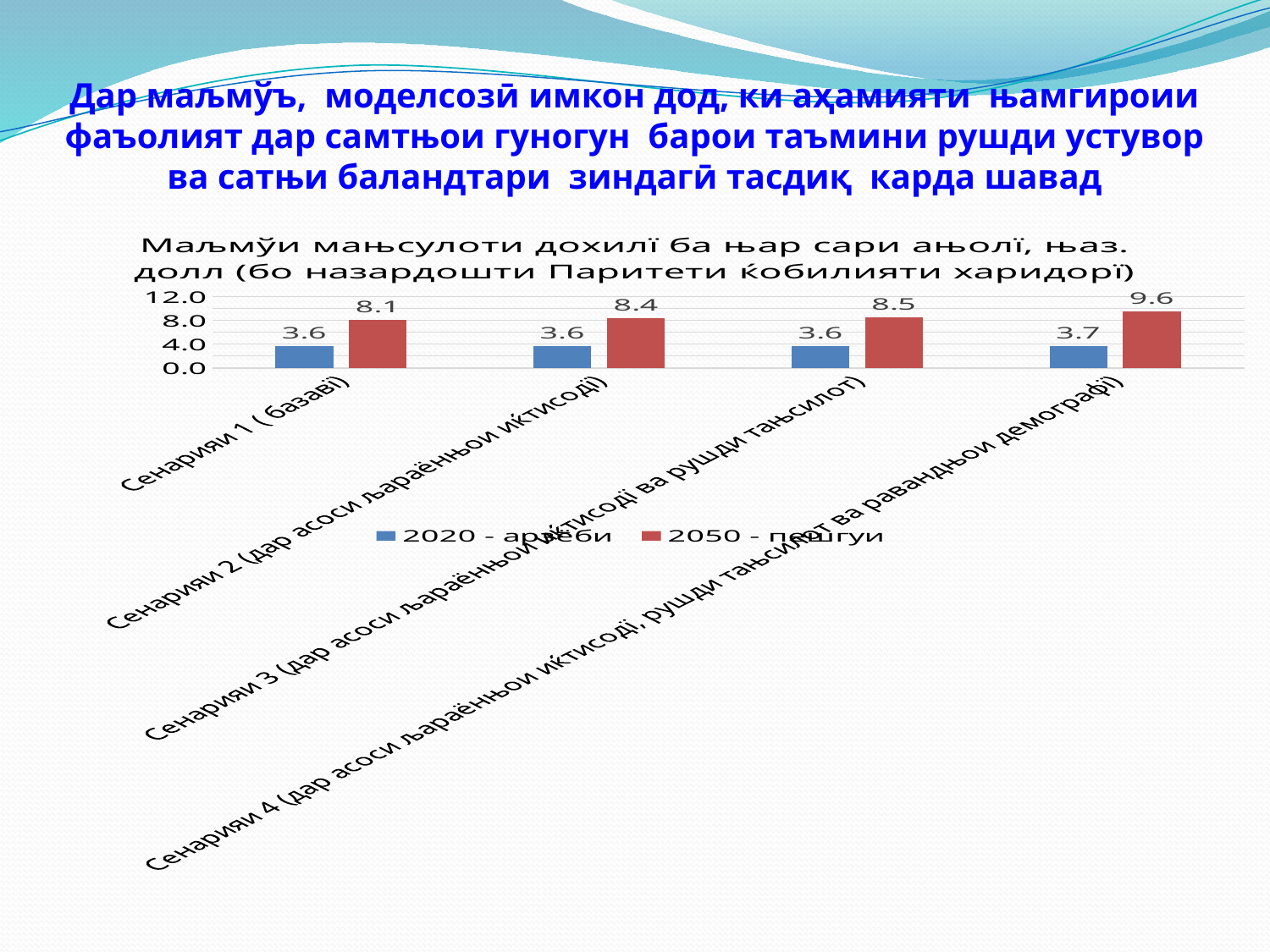
How many scenarios (categories) are shown on the x axis? 4 Which scenario has the lowest 2050 value? Сенарияи 1 (базавї) What is the difference between the 2050 values of Сенарияи 4 and Сенарияи 1? 1.5 What is the difference between the 2050 and 2020 values for Сенарияи 4? 5.9 Which is larger: the 2050 value for Сенарияи 2 or for Сенарияи 3? Сенарияи 3 What kind of chart is shown on the slide? Bar chart How many series does the legend list? 2 Which scenario has the highest 2050 value? Сенарияи 4 What is the 2050 value for Сенарияи 1 (базавї)? 8.1 What is the 2020 value for Сенарияи 4? 3.7 Do the 2050 values rise or fall from Сенарияи 1 to Сенарияи 4? Rise What is the 2050 value for Сенарияи 3? 8.5